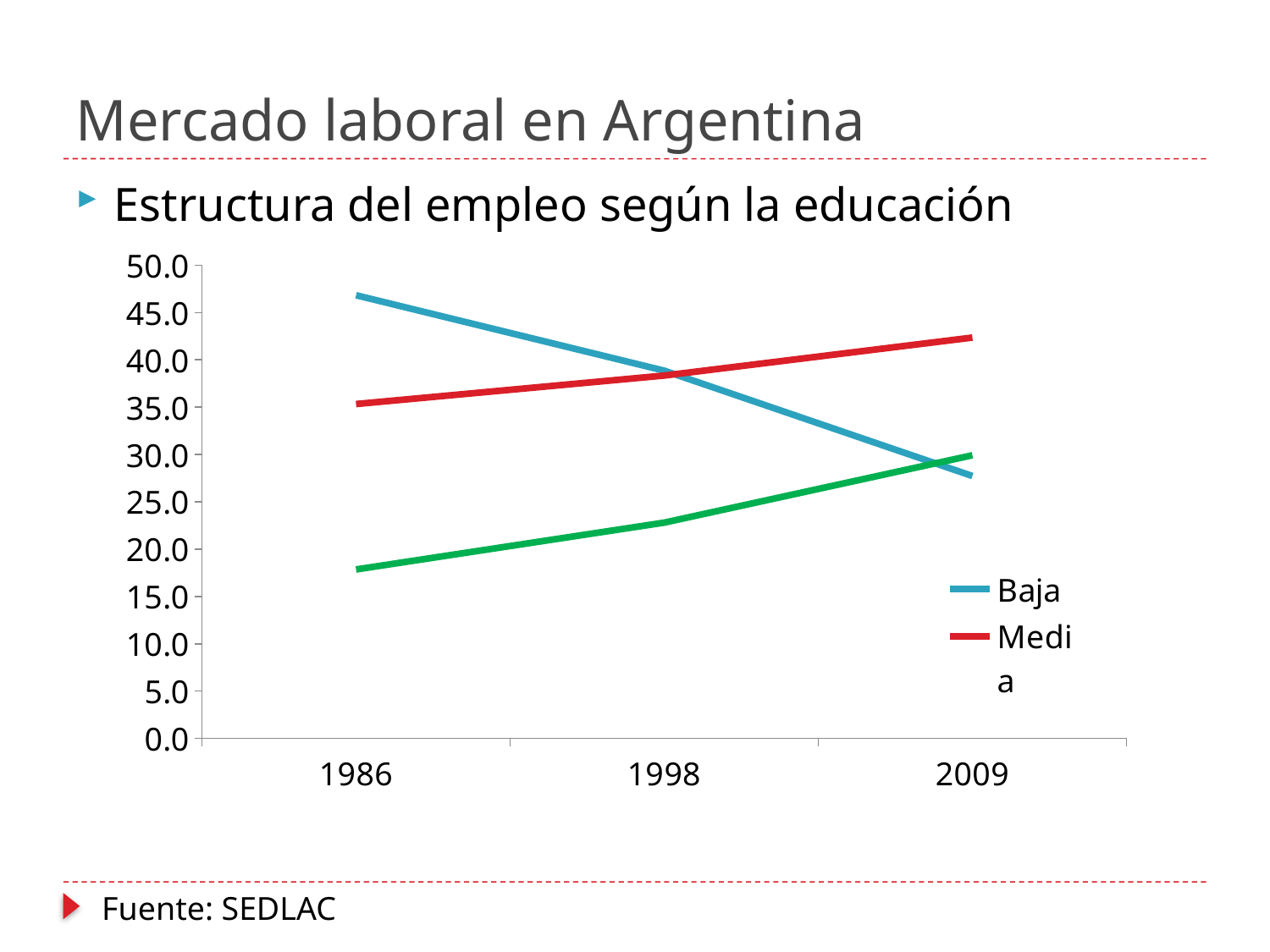
Is the value for Media in 1986 greater or less than 40.0? less Is the value for Media in 2009 greater or less than 40.0? greater Does the Media series rise or fall from 1986 to 2009? rise In 1986, which is larger, Baja or Media? Baja Does the Baja series rise or fall from 1986 to 2009? fall In 2009, which is larger, Baja or Media? Media What kind of chart is shown on the slide? line chart How many years are shown on the x axis of the chart? 3 Is the value for Baja in 1986 greater or less than 45.0? greater What colour is the line for the Baja series? blue How many lines are plotted on the chart? 3